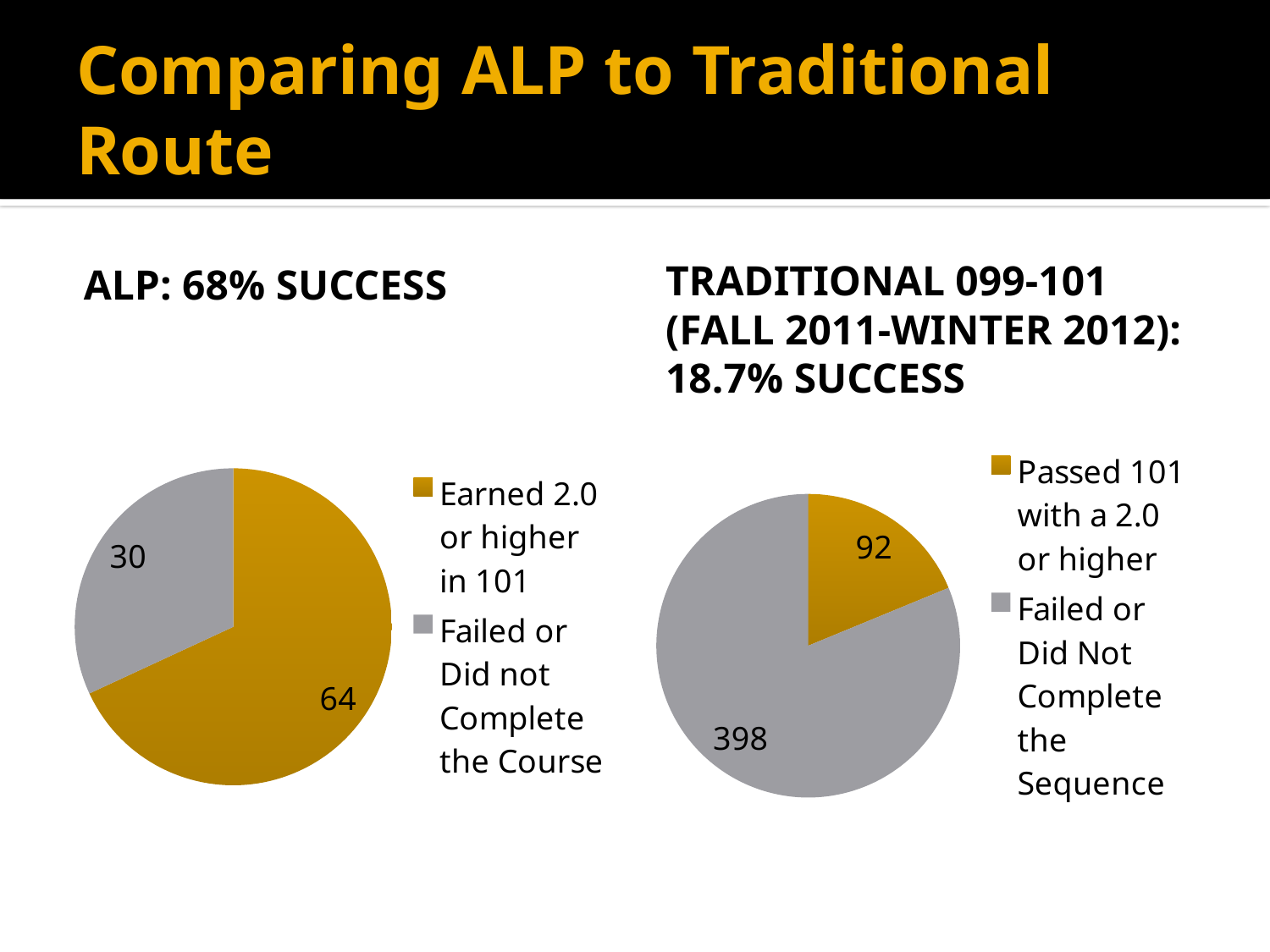
In the ALP: 68% SUCCESS chart, what is the value for Earned 2.0 or higher in 101? 64 In the ALP: 68% SUCCESS chart, what is the value for Failed or Did not Complete the Course? 30 In the ALP: 68% SUCCESS chart, which slice is the largest? Earned 2.0 or higher in 101 What kind of chart is the ALP: 68% SUCCESS chart? pie chart In the TRADITIONAL 099-101 chart, which slice is the smallest? Passed 101 with a 2.0 or higher In the ALP: 68% SUCCESS chart, what share of the pie is the Earned 2.0 or higher in 101 slice? 68% In the TRADITIONAL 099-101 chart, what is the total of the two slices? 490 How many slices does the TRADITIONAL 099-101 chart have? 2 In the TRADITIONAL 099-101 chart, what is the value for Failed or Did Not Complete the Sequence? 398 In the ALP: 68% SUCCESS chart, what is the difference between the Earned 2.0 or higher in 101 slice and the Failed or Did not Complete the Course slice? 34 In the TRADITIONAL 099-101 chart, what is the difference between the Failed or Did Not Complete the Sequence slice and the Passed 101 with a 2.0 or higher slice? 306 In the TRADITIONAL 099-101 chart, what is the value for Passed 101 with a 2.0 or higher? 92